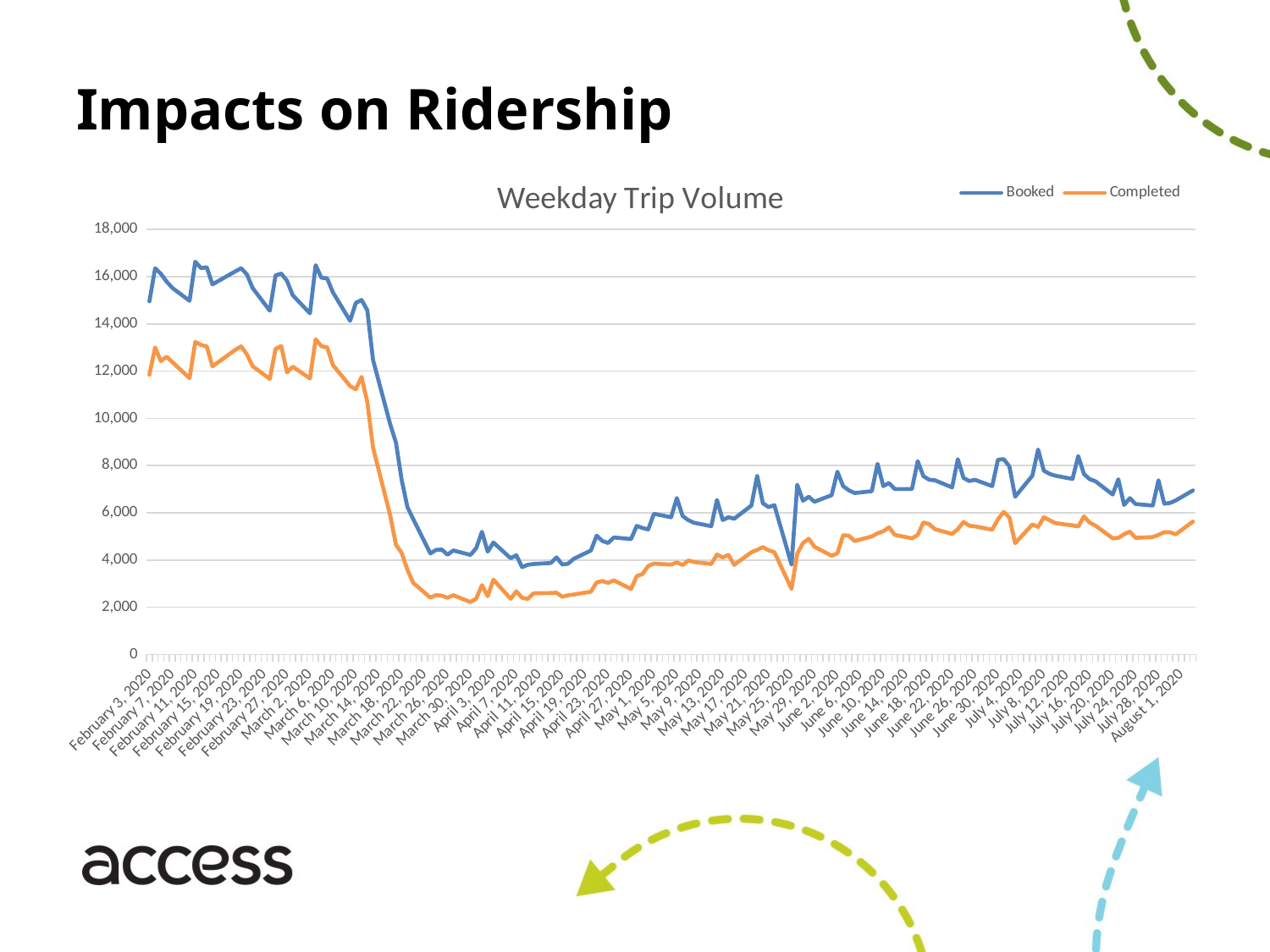
How many series does the legend of the Weekday Trip Volume chart list? 2 Is the Completed value on April 11, 2020 greater or less than 4,000? less Between February 3, 2020 and April 3, 2020, does the Booked series rise or fall overall? Fall Is the Completed value on February 3, 2020 greater or less than 14,000? less Between April 15, 2020 and June 30, 2020, does the Completed series rise or fall overall? Rise What is the title of the chart on the slide? Weekday Trip Volume What kind of chart is shown on the slide? Line chart On March 2, 2020, which series has the larger value, Booked or Completed? Booked Which colour is used for the Completed series in the Weekday Trip Volume chart? Orange Is the Booked value on February 3, 2020 greater or less than 14,000? greater